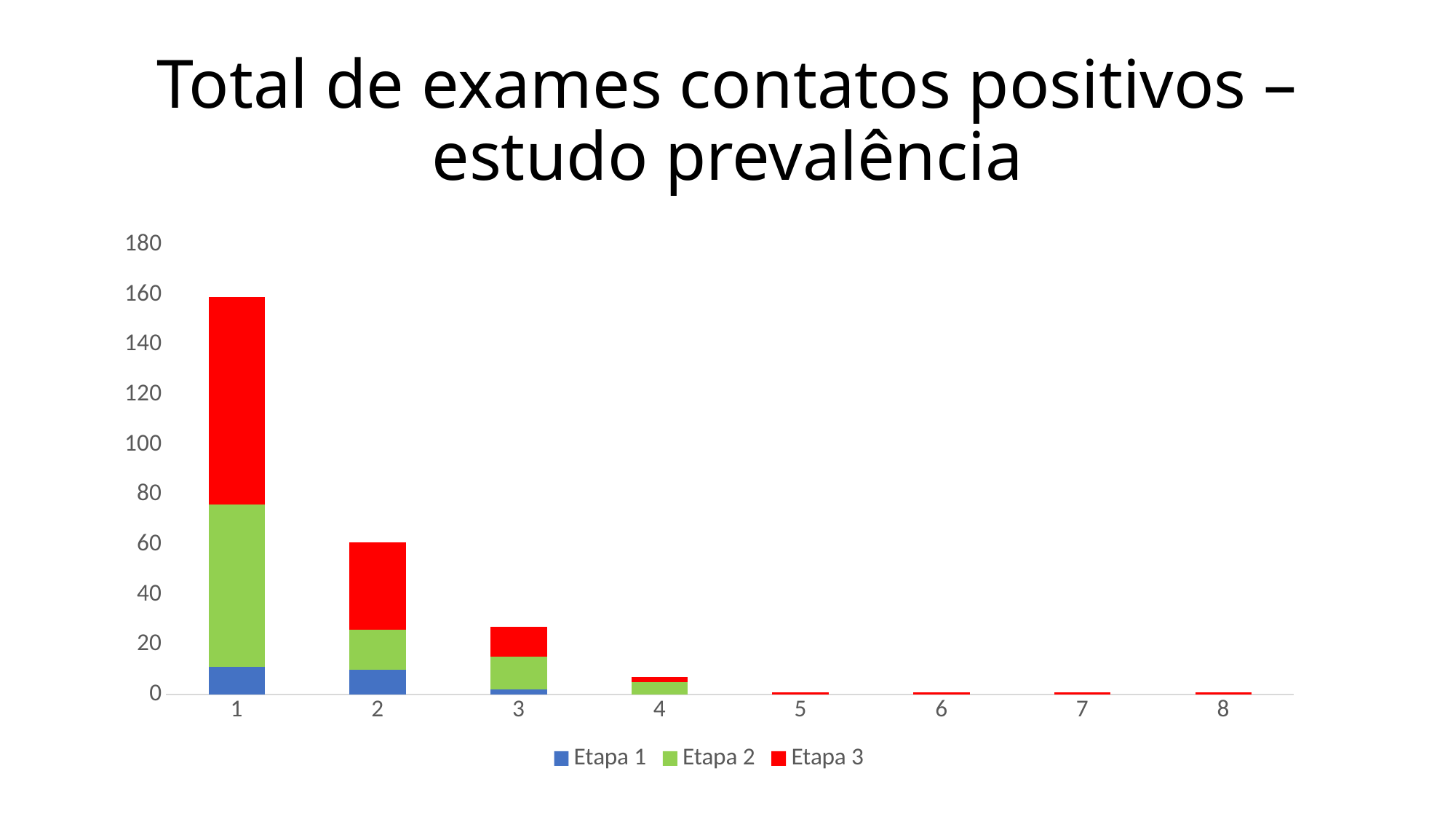
What kind of chart is shown on the slide? stacked bar chart What are the three series named in the legend? Etapa 1, Etapa 2, Etapa 3 How many categories are shown on the x axis? 8 Is the total value for category 3 greater or less than 20? greater Which category has the highest total bar? 1 Is the total value for category 2 greater or less than 80? less Do the total bar values rise or fall from category 1 to category 8? fall Which has the larger total bar, category 1 or category 2? 1 Is the total value for category 4 greater or less than 20? less What colour represents Etapa 3 in the chart? red How many series does the legend list? 3